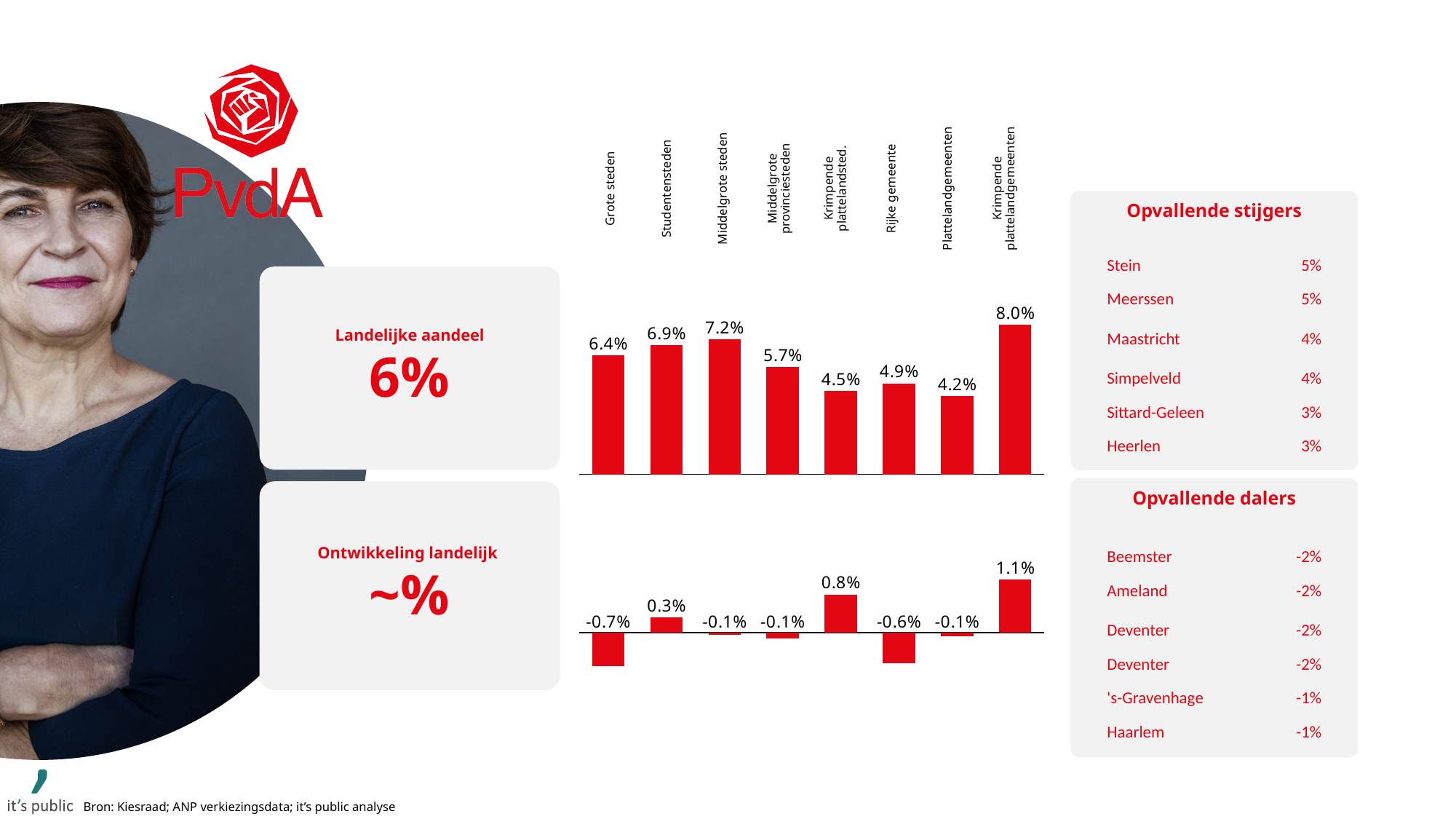
What type of chart is the top chart (Landelijke aandeel)? Bar chart In the top chart (Landelijke aandeel), what is the difference between Middelgrote steden and Krimpende plattelandsted.? 2.7% In the top chart (Landelijke aandeel), what is the value for Rijke gemeente? 4.9% In the bottom chart (Ontwikkeling landelijk), which category has the highest value? Krimpende plattelandgemeenten In the top chart (Landelijke aandeel), which category has the highest value? Krimpende plattelandgemeenten In the top chart (Landelijke aandeel), which category has the lowest value? Plattelandgemeenten In the top chart (Landelijke aandeel), which is larger: Studentensteden or Middelgrote provinciesteden? Studentensteden In the bottom chart (Ontwikkeling landelijk), what is the value for Grote steden? -0.7% How many categories are shown in the top chart (Landelijke aandeel)? 8 In the bottom chart (Ontwikkeling landelijk), which category has the lowest value? Grote steden In the top chart (Landelijke aandeel), what is the value for Grote steden? 6.4% In the bottom chart (Ontwikkeling landelijk), what is the value for Krimpende plattelandsted.? 0.8%